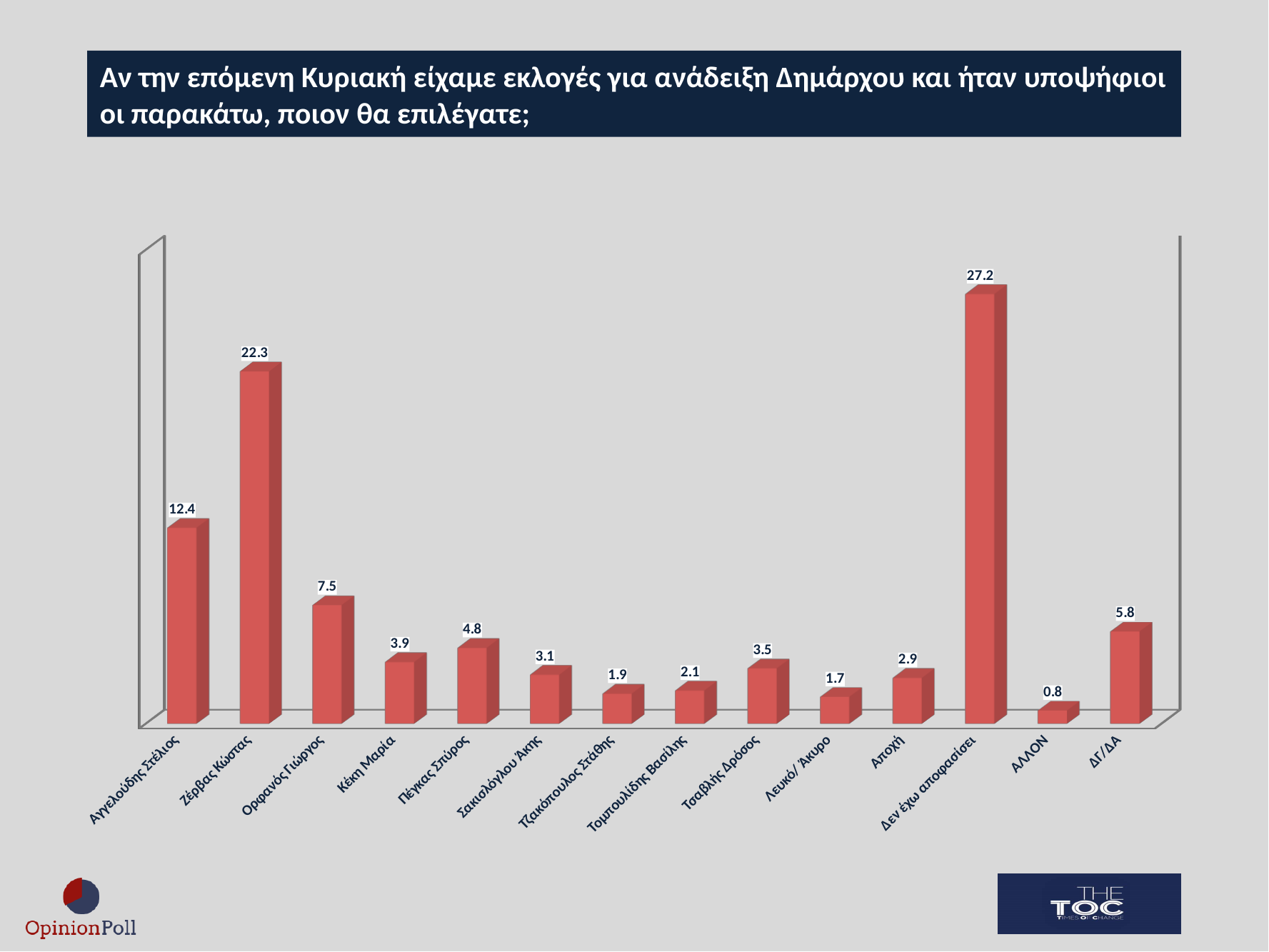
What is the difference between the values for Δεν έχω αποφασίσει and Ζέρβας Κώστας? 4.9 What is the difference between the values for Ζέρβας Κώστας and Αγγελούδης Στέλιος? 9.9 Which category has the highest value? Δεν έχω αποφασίσει Which is larger, the value for Πέγκας Σπύρος or the value for Κέκη Μαρία? Πέγκας Σπύρος What value is shown for Αγγελούδης Στέλιος? 12.4 Which category has the lowest value? ΑΛΛΟΝ What value is shown for Ζέρβας Κώστας? 22.3 What kind of chart is shown on the slide? Bar chart What value is shown for ΔΓ/ΔΑ? 5.8 Which candidate among the named individuals has the highest value? Ζέρβας Κώστας What value is shown for Ορφανός Γιώργος? 7.5 How many categories are shown on the chart? 14